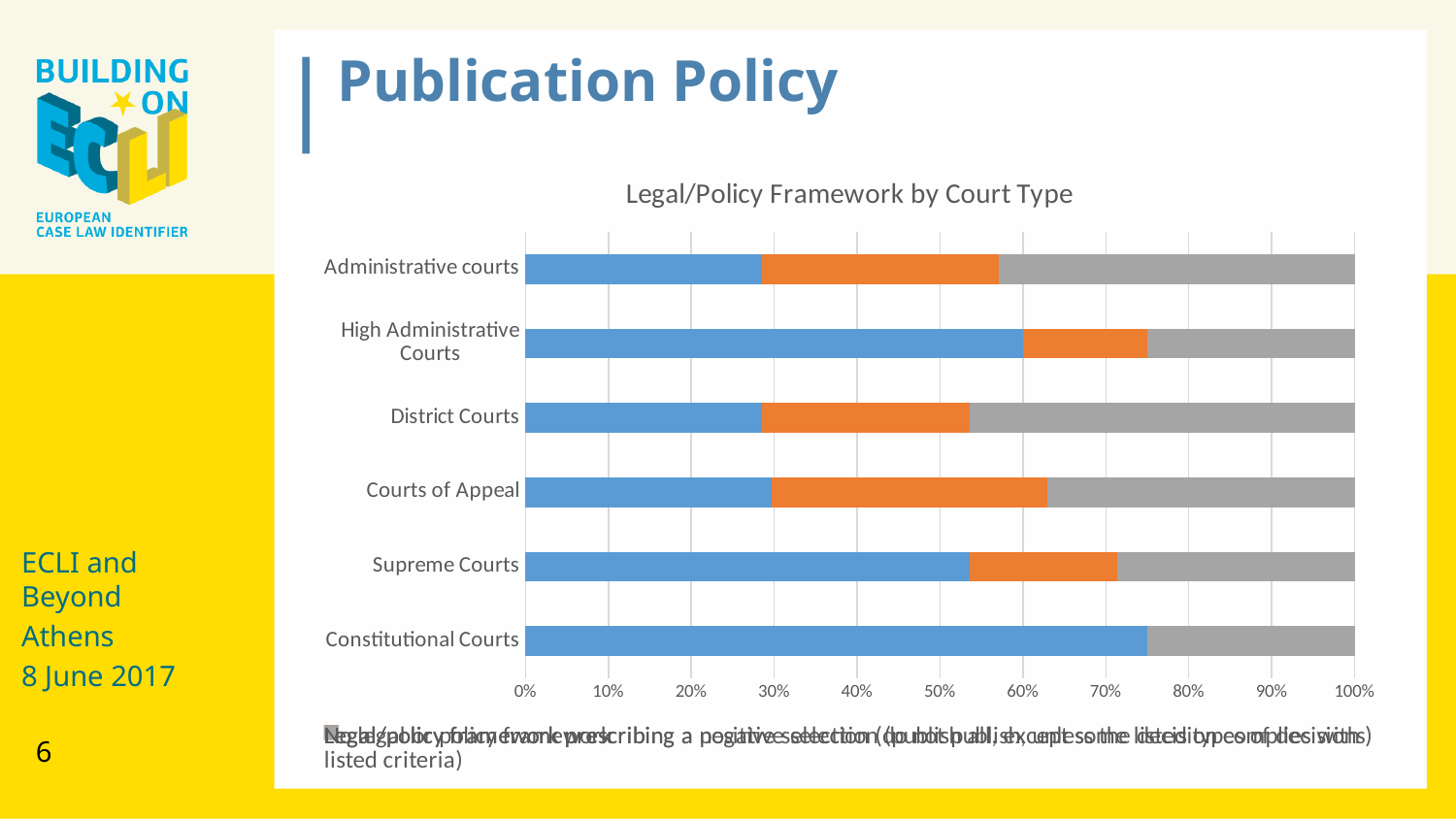
Which has a larger blue segment, Administrative courts or Constitutional Courts? Constitutional Courts Which court type has the largest blue segment? Constitutional Courts Which has a larger blue segment, Supreme Courts or District Courts? Supreme Courts What kind of chart is shown on the slide? Stacked bar chart Is the blue segment for Constitutional Courts greater or less than 70%? greater Is the blue segment for Supreme Courts greater or less than 50%? greater What is the title of the chart? Legal/Policy Framework by Court Type Is the blue segment for Administrative courts greater or less than 30%? less How many court types are listed on the chart's vertical axis? 6 What is the maximum value shown on the horizontal axis? 100% Which court type has no orange segment in its bar? Constitutional Courts